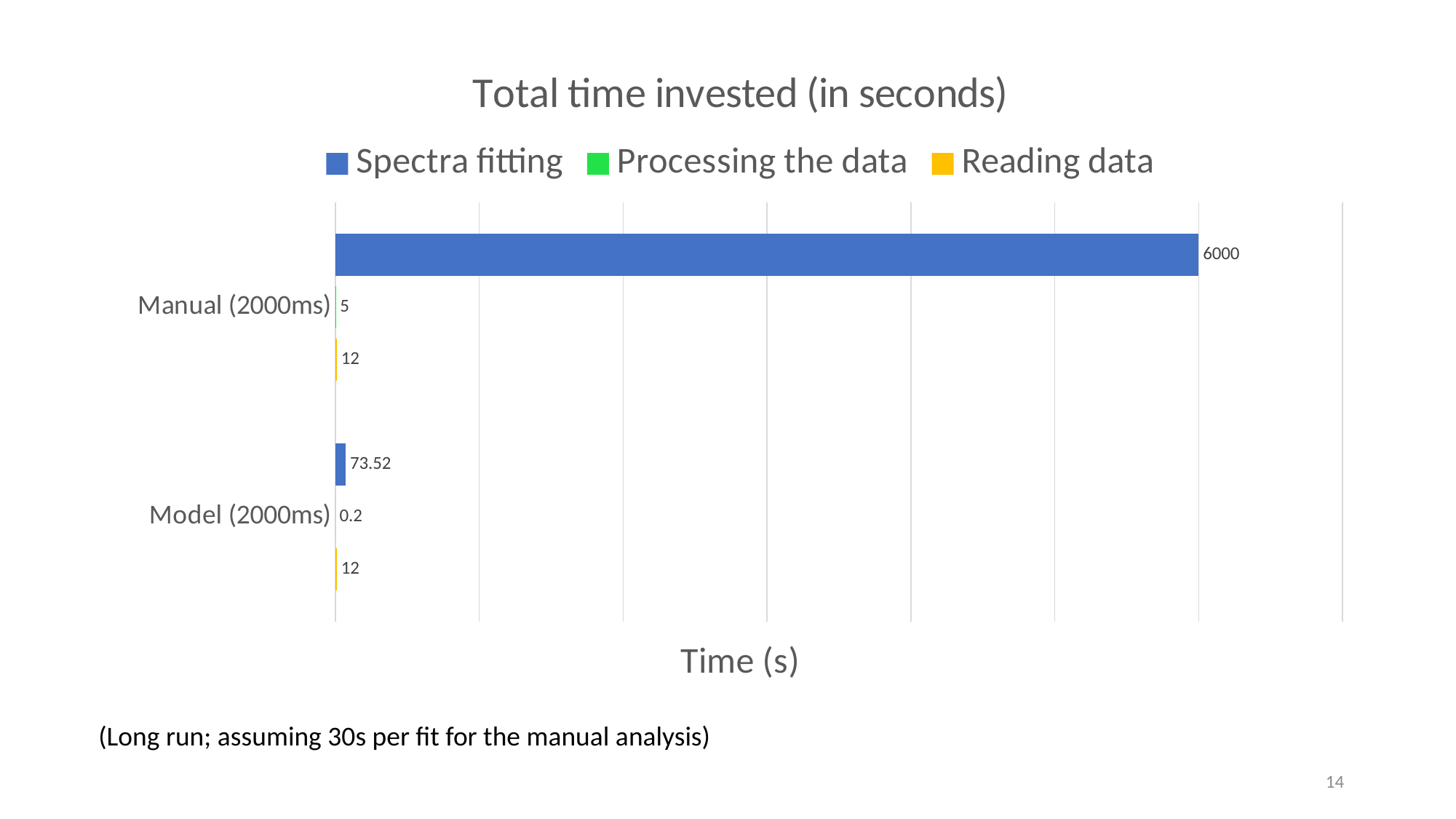
What kind of chart is shown on the slide? Bar chart What is the difference between the Spectra fitting values for Manual (2000ms) and Model (2000ms)? 5926.48 How many series does the legend list? 3 Which is larger: the Reading data value for Manual (2000ms) or the Spectra fitting value for Model (2000ms)? Spectra fitting value for Model (2000ms) What is the Spectra fitting value for Manual (2000ms)? 6000 What is the Spectra fitting value for Model (2000ms)? 73.52 Which category has the lowest Processing the data value? Model (2000ms) What is the title of the chart? Total time invested (in seconds) Which category has the highest Spectra fitting value? Manual (2000ms) What is the Processing the data value for Model (2000ms)? 0.2 What is the Processing the data value for Manual (2000ms)? 5 What is the Reading data value for Model (2000ms)? 12